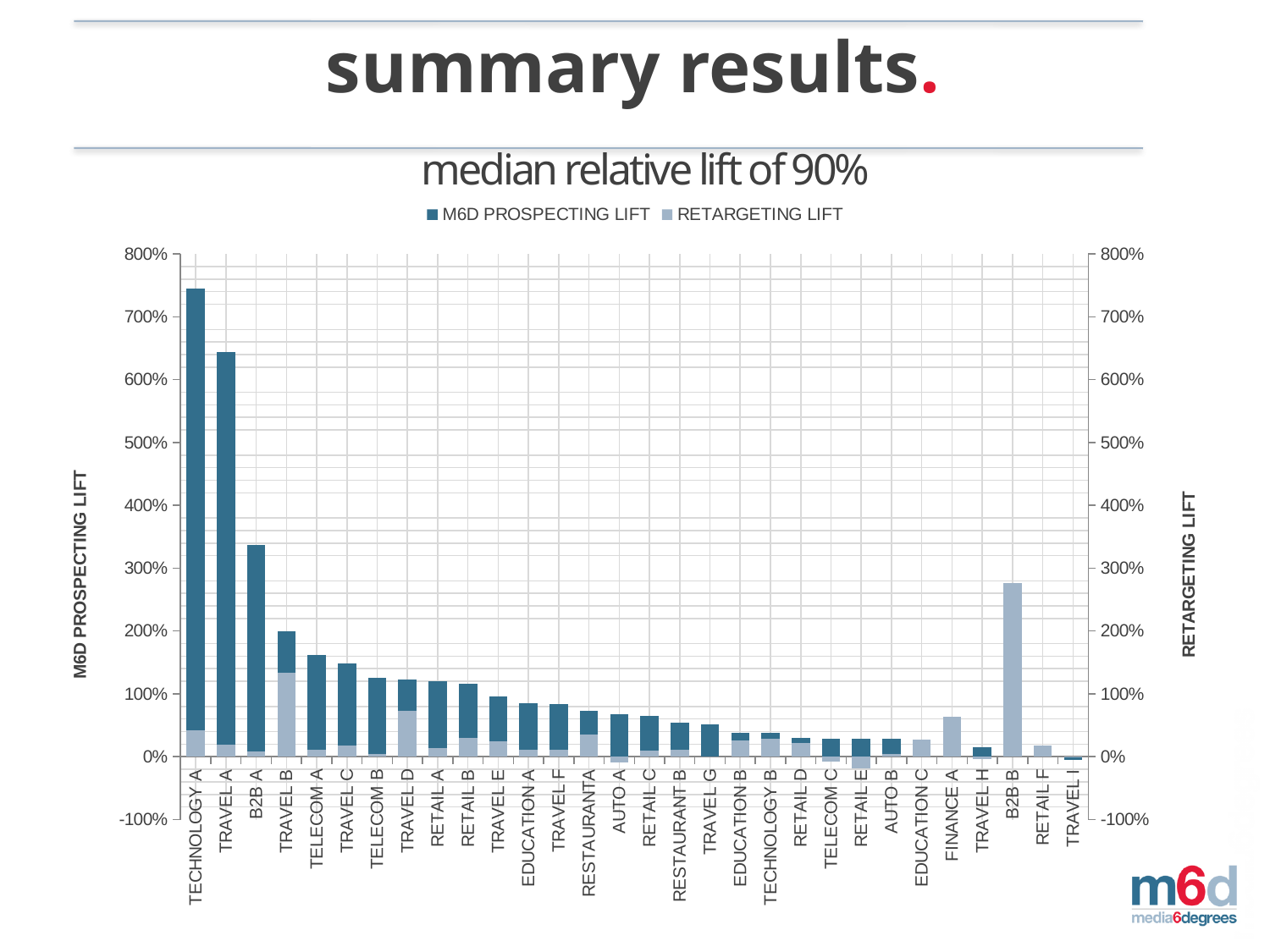
How many series does the chart legend list? 2 Which has the larger M6D PROSPECTING LIFT, TECHNOLOGY A or TRAVEL A? TECHNOLOGY A How many categories are plotted along the x axis of the chart? 30 Is the M6D PROSPECTING LIFT for B2B A greater or less than 400%? less Is the RETARGETING LIFT for B2B B greater or less than 200%? greater Which category has the highest M6D PROSPECTING LIFT? TECHNOLOGY A What kind of chart is shown on the slide? bar chart Do the M6D PROSPECTING LIFT values generally rise or fall from left to right along the x axis? fall What is the title of the chart? median relative lift of 90% Which category has the highest RETARGETING LIFT? B2B B Is the M6D PROSPECTING LIFT for TECHNOLOGY A greater or less than 700%? greater